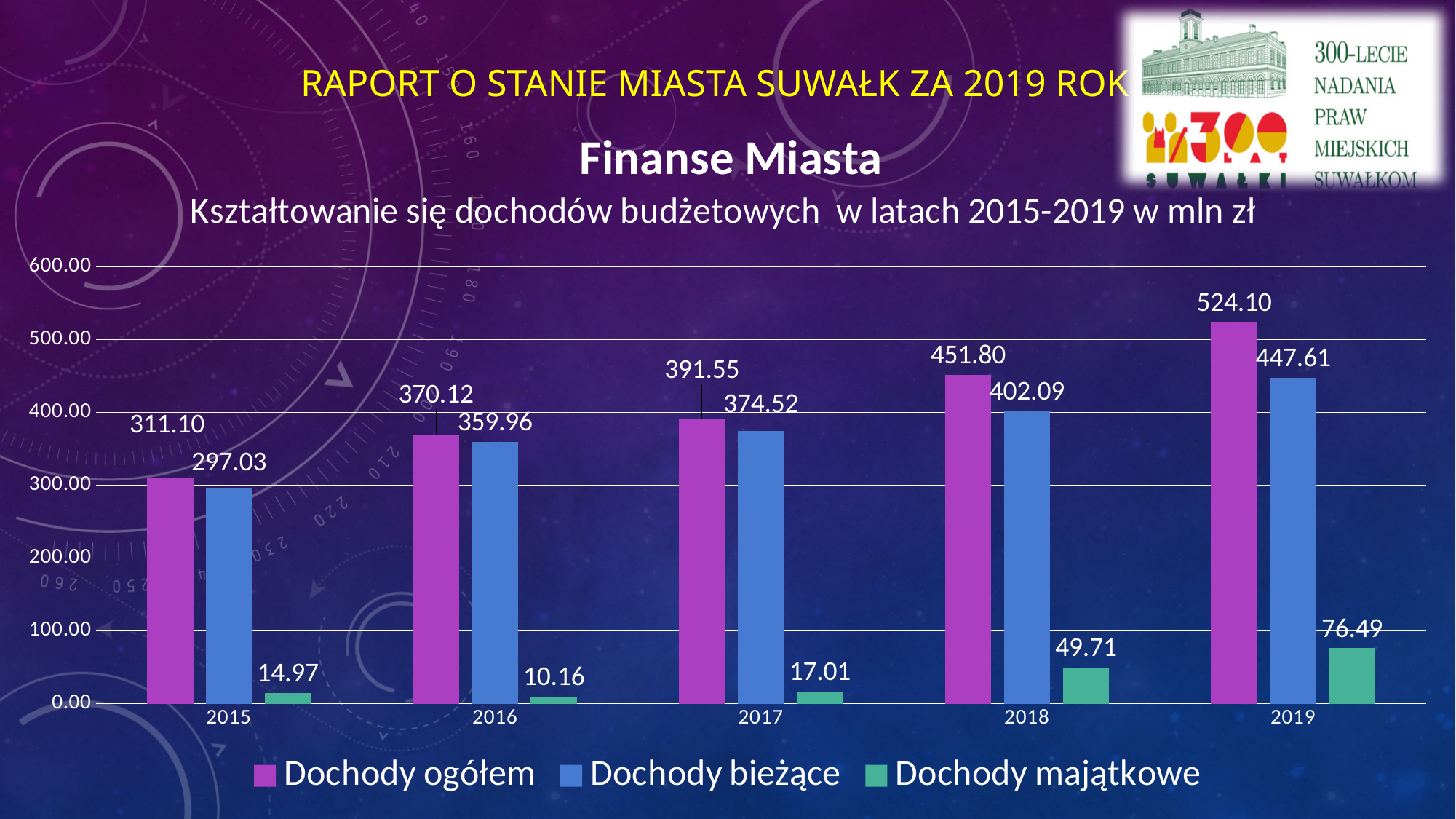
Which year has the lowest value for Dochody majątkowe? 2016 Which year has the highest value for Dochody ogółem? 2019 Do the values for Dochody ogółem rise or fall from 2015 to 2019? rise What is the value of Dochody ogółem for 2019? 524.10 Is the value of Dochody bieżące for 2018 greater or less than 400.00? greater How many series does the legend list? 3 What kind of chart is shown on the slide? bar chart What is the difference between Dochody ogółem and Dochody bieżące in 2017? 17.03 What is the value of Dochody majątkowe for 2018? 49.71 What is the value of Dochody bieżące for 2016? 359.96 Which is larger: Dochody majątkowe in 2015 or in 2017? 2017 How many years are shown on the x axis? 5